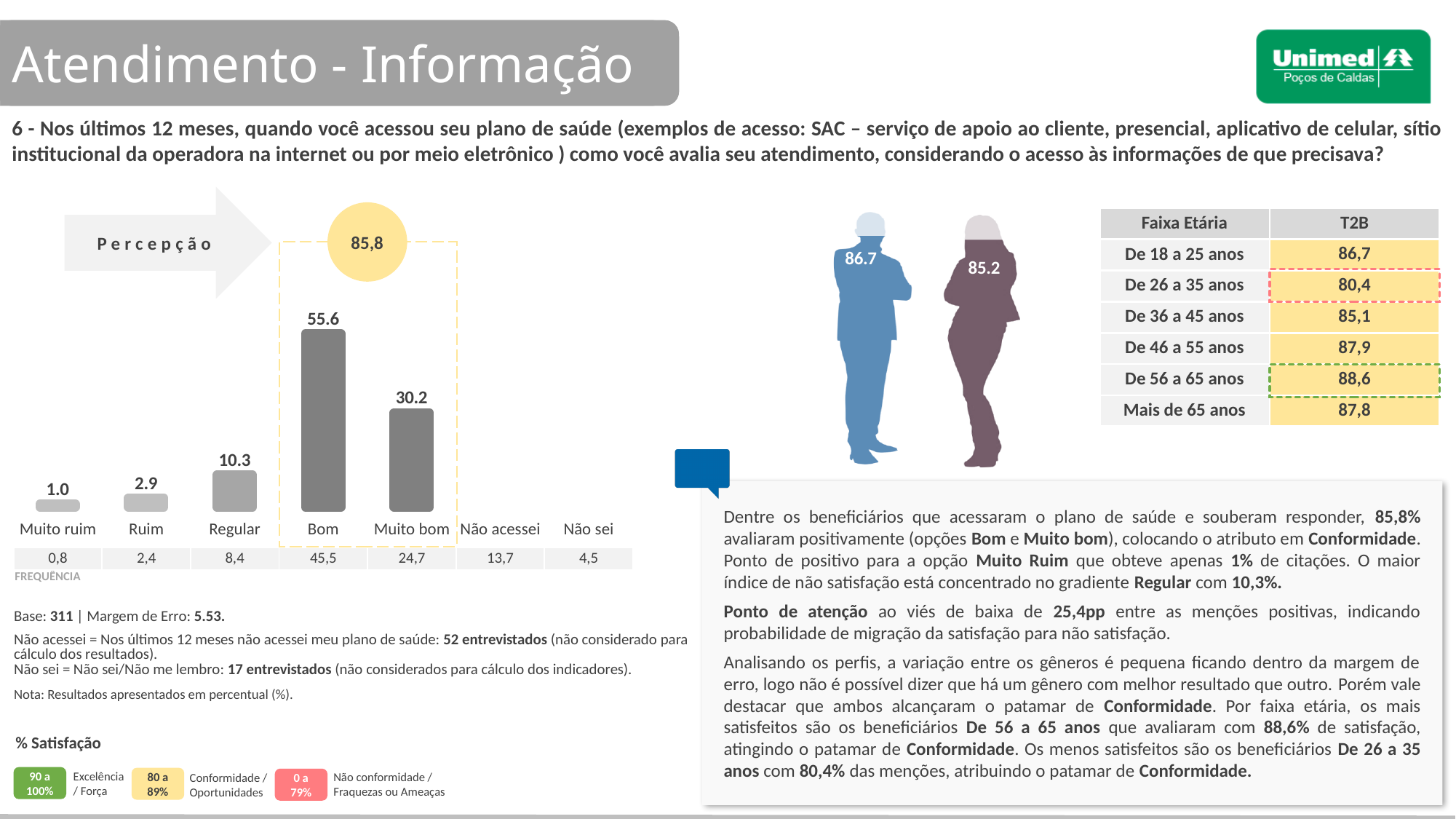
What type of chart is used to show the Percepção results? Bar chart What is the value shown for the Muito bom bar in the bar chart? 30.2 What is the combined value of the Bom and Muito bom bars, as shown in the yellow circle above the chart? 85,8 How many bars are plotted in the bar chart? 5 Which is larger in the bar chart, the value for Ruim or the value for Regular? Regular What is the difference between the Bom and Muito bom values in the bar chart? 25.4 What is the frequency value shown below the Bom bar in the FREQUÊNCIA row? 45,5 Which category has the highest bar in the bar chart? Bom What is the value shown for the Muito ruim bar in the bar chart? 1.0 Which category has the lowest bar in the bar chart? Muito ruim What is the value shown for the Bom bar in the bar chart? 55.6 What is the value shown for the Regular bar in the bar chart? 10.3